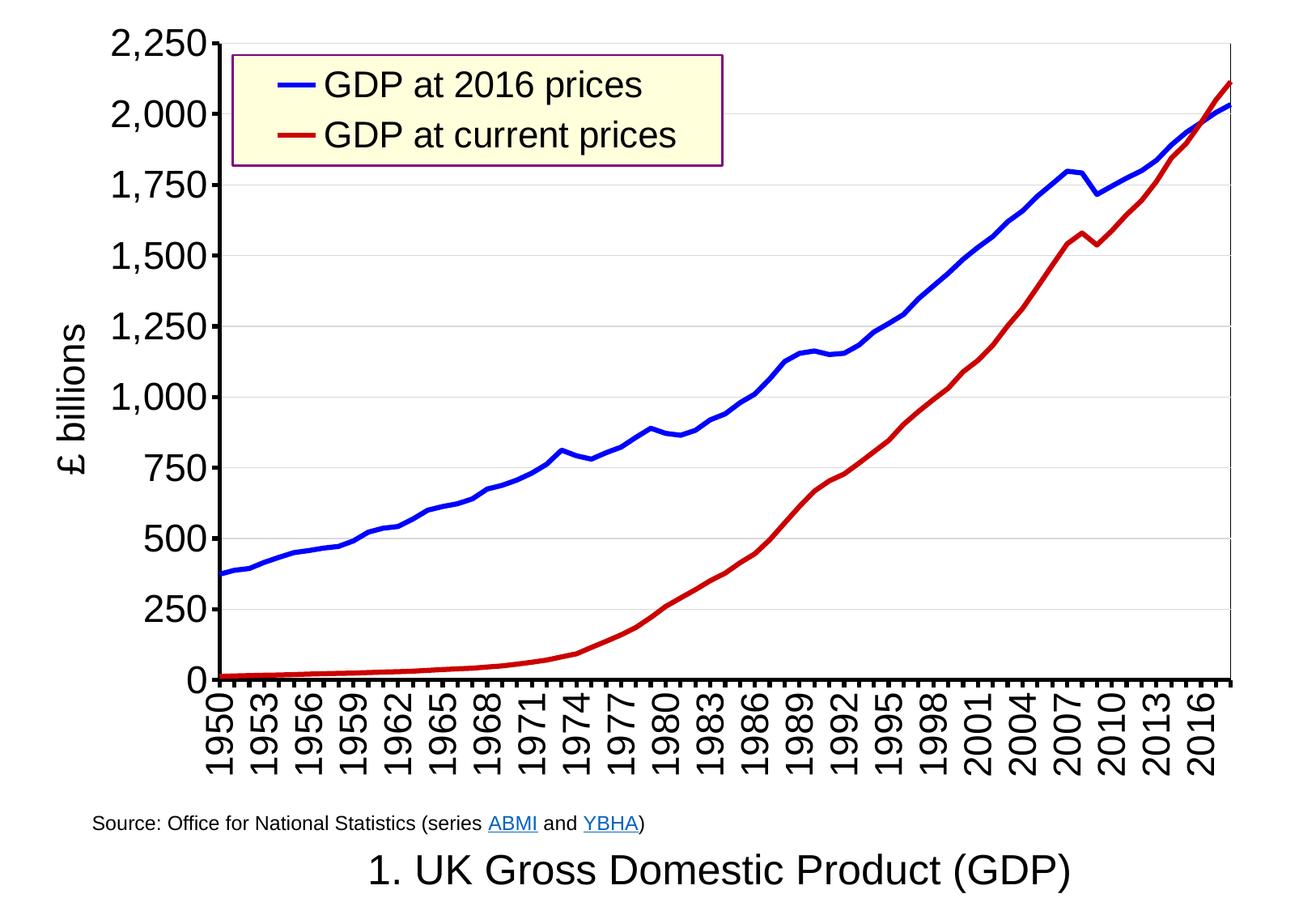
Is the value for GDP at current prices in 1989 greater or less than 500? greater In 2001, which series has the higher value, GDP at 2016 prices or GDP at current prices? GDP at 2016 prices What kind of chart is shown on the slide? line chart In 1980, which series has the higher value, GDP at 2016 prices or GDP at current prices? GDP at 2016 prices What is the title of the chart? 1. UK Gross Domestic Product (GDP) Overall, does GDP at current prices rise or fall from 1950 to the end of the series? rise How many series does the legend list? 2 Is the value for GDP at 2016 prices in 1950 greater or less than 250? greater Which colour is used for the 'GDP at 2016 prices' series? blue Is the value for GDP at current prices in 1950 greater or less than 250? less